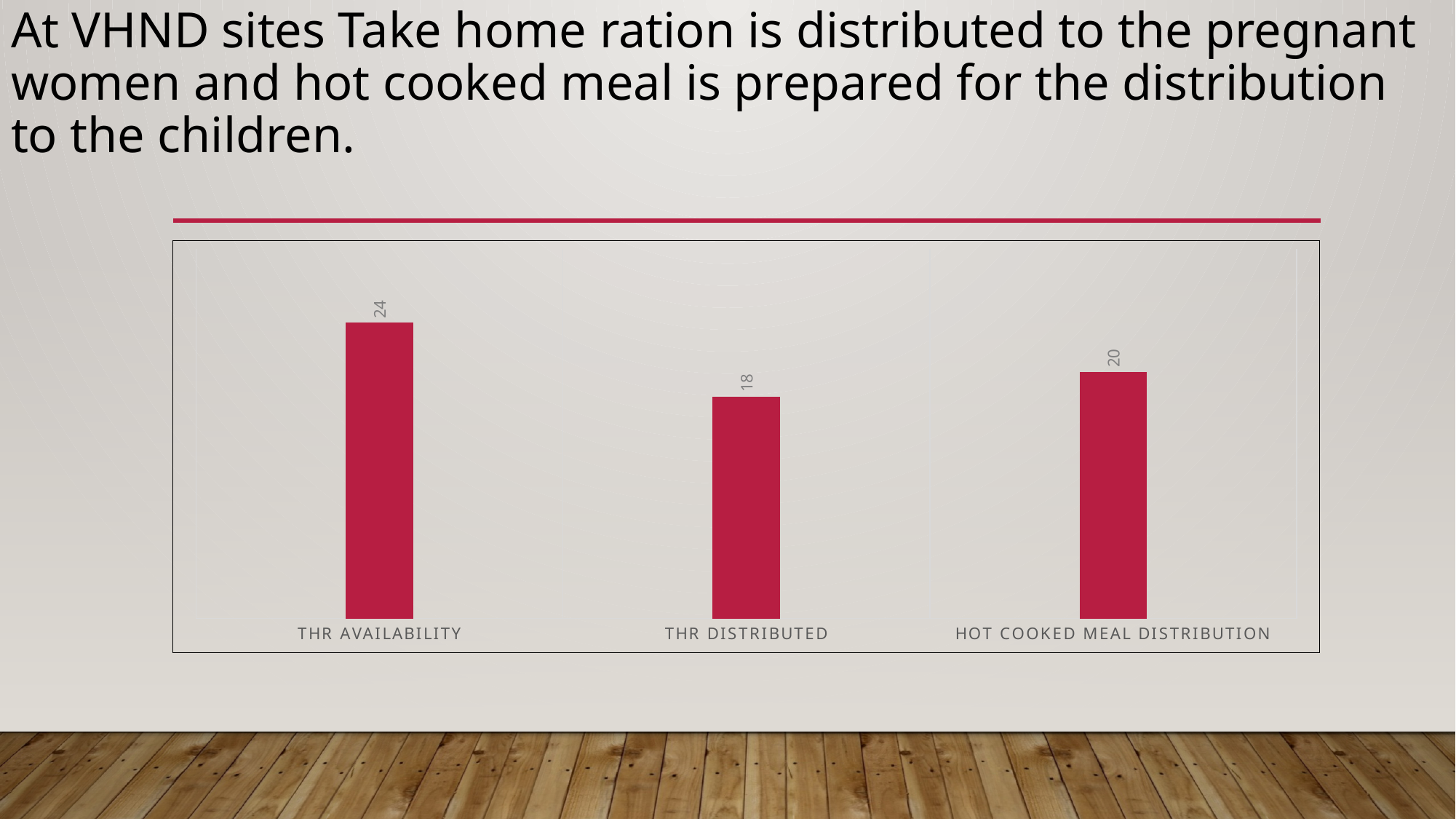
How many categories are shown in the chart? 3 What is the value for Hot Cooked Meal Distribution? 20 What is the difference between THR Availability and THR Distributed? 6 What is the value for THR Distributed? 18 Do the values rise or fall from THR Availability to THR Distributed? Fall What kind of chart is shown on the slide? Bar chart Which category has the highest value? THR Availability Which category has the lowest value? THR Distributed What is the difference between Hot Cooked Meal Distribution and THR Distributed? 2 What is the value for THR Availability? 24 Which is larger, THR Availability or Hot Cooked Meal Distribution? THR Availability What colour are the bars in the chart? Red